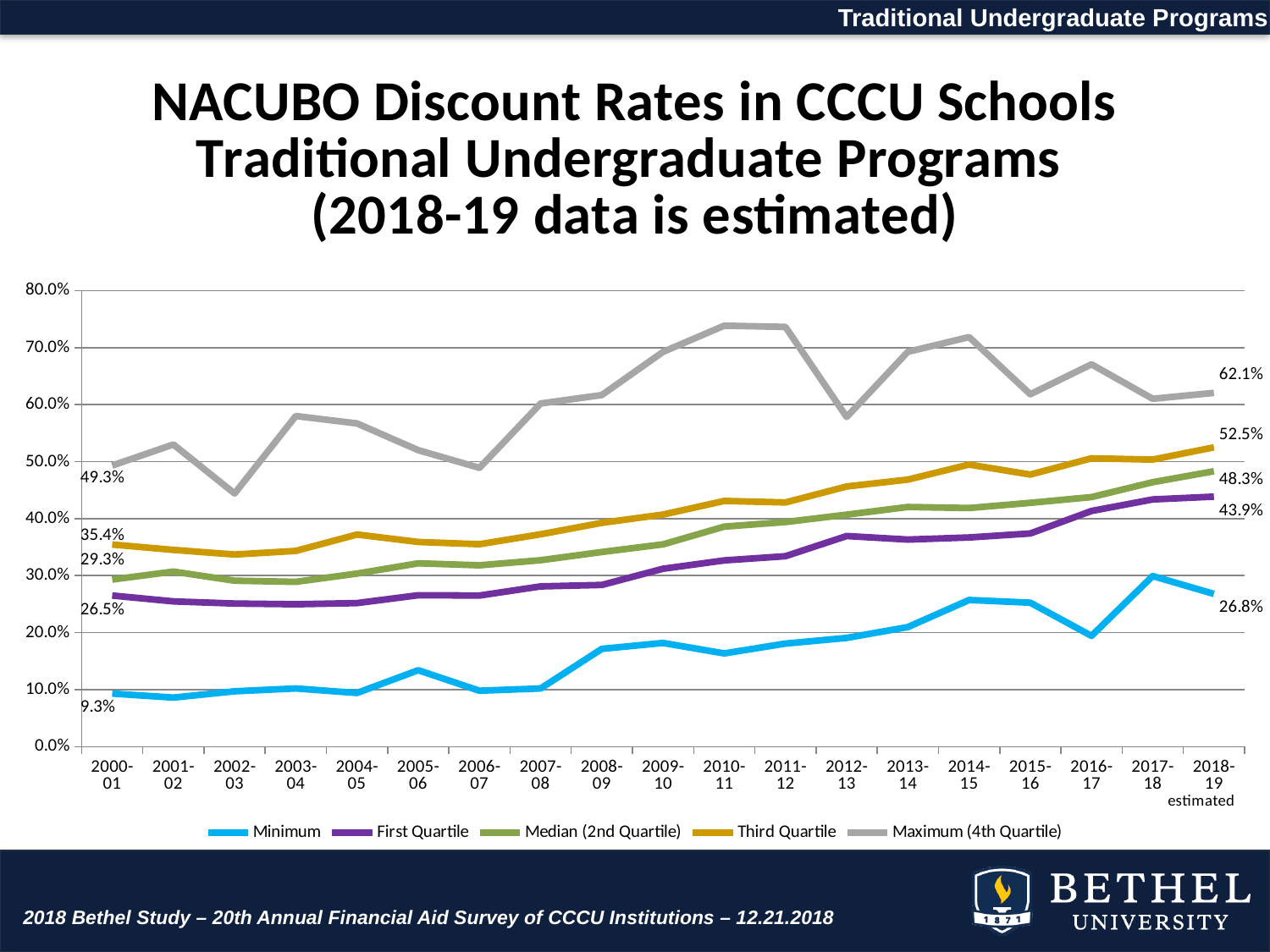
Is the Maximum (4th Quartile) value for 2010-11 greater or less than 70.0%? greater What is the Median (2nd Quartile) discount rate for 2000-01? 29.3% What is the estimated Third Quartile discount rate for 2018-19? 52.5% Does the First Quartile series generally rise or fall from 2000-01 to 2018-19? Rise How many academic years are plotted along the x axis? 19 What is the Minimum discount rate for 2000-01? 9.3% What type of chart is shown on the slide? Line chart How many series does the legend list? 5 By how much did the Minimum discount rate change from 2000-01 (9.3%) to the 2018-19 estimate (26.8%)? 17.5 percentage points What is the difference between the Maximum (4th Quartile) and Minimum values for 2018-19? 35.3 percentage points What is the estimated Maximum (4th Quartile) discount rate for 2018-19? 62.1% Which series has the highest value in 2018-19? Maximum (4th Quartile)